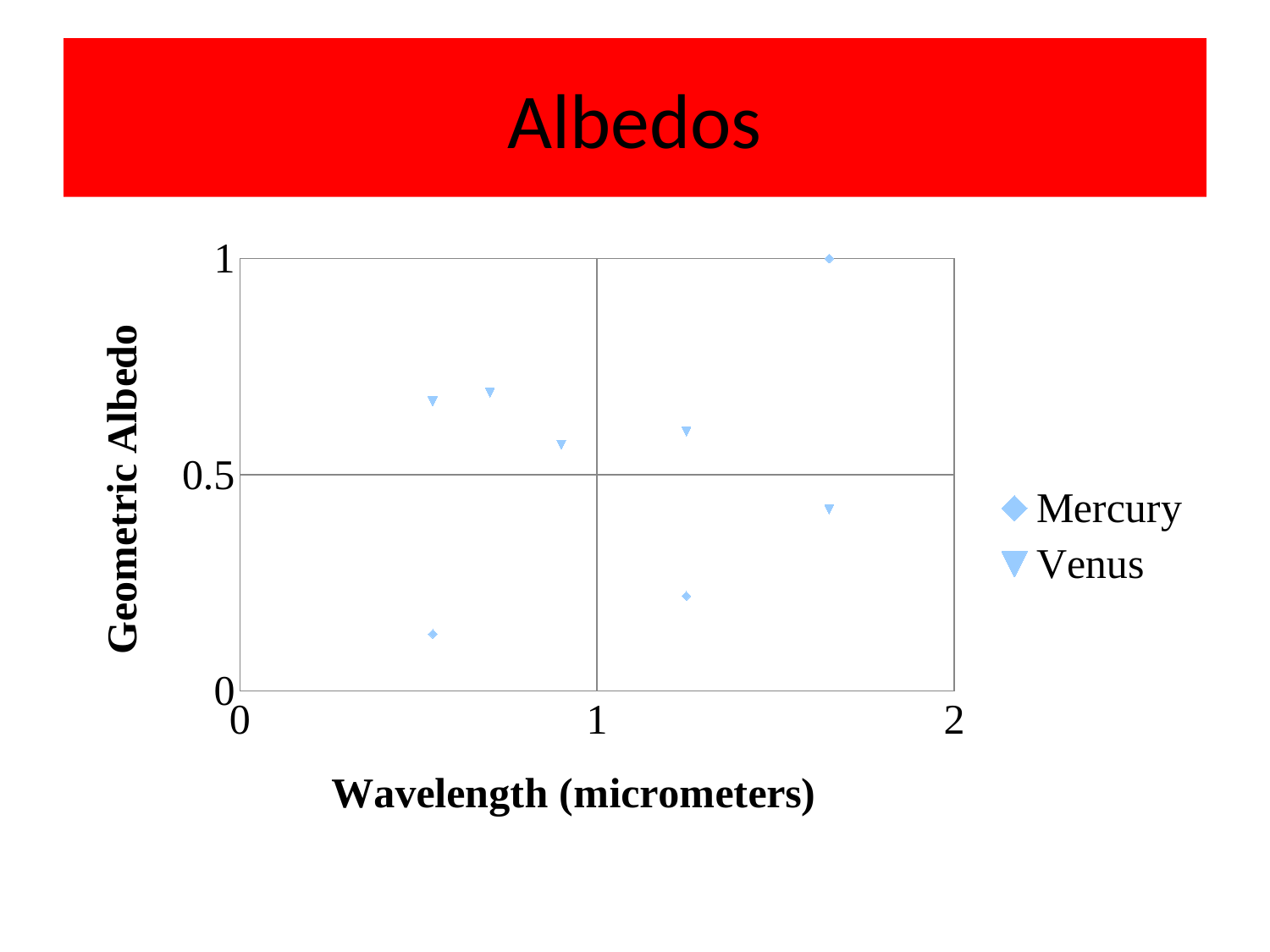
Is the geometric albedo of the Venus point with the longest wavelength greater or less than 0.5? less How many series does the legend list? 2 Is the geometric albedo of the Mercury point with the shortest wavelength greater or less than 0.5? less Is the geometric albedo of the Mercury point with the longest wavelength greater or less than 0.5? greater Which series has the single highest geometric albedo value plotted? Mercury Which series has the single lowest geometric albedo value plotted? Mercury Which two series are listed in the legend? Mercury and Venus What kind of chart is shown on the slide? scatter chart How many Mercury data points are plotted? 3 What is the title of the slide containing the chart? Albedos How many Venus data points are plotted? 5 Do the Mercury values rise or fall as wavelength increases? rise